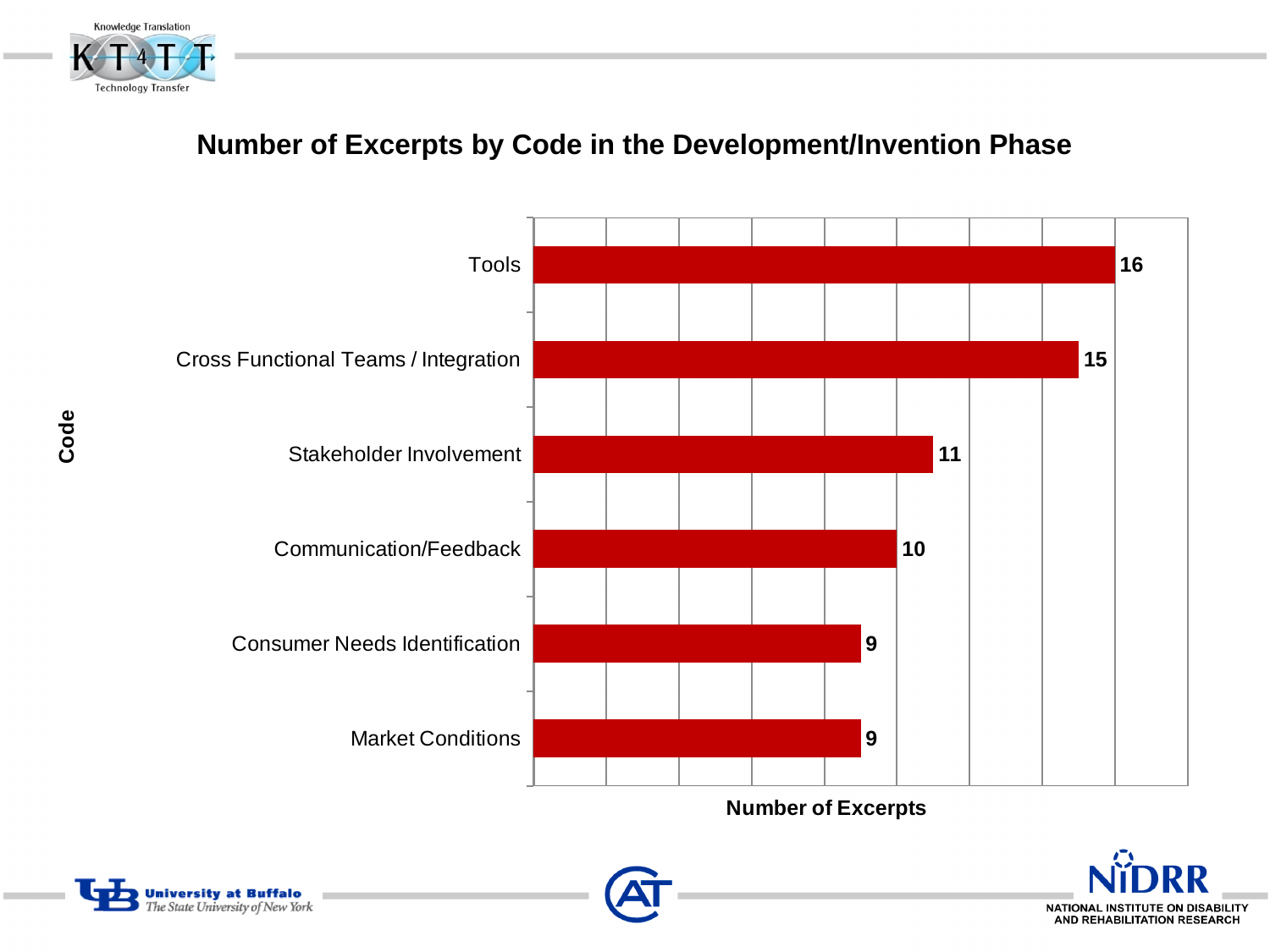
What is the number of excerpts for Communication/Feedback? 10 What is the number of excerpts for Stakeholder Involvement? 11 What is the number of excerpts for Cross Functional Teams / Integration? 15 What kind of chart is shown on the slide? Bar chart What is the difference in number of excerpts between Cross Functional Teams / Integration and Stakeholder Involvement? 4 Which has more excerpts, Stakeholder Involvement or Communication/Feedback? Stakeholder Involvement What is the number of excerpts for Tools? 16 What is the difference in number of excerpts between Tools and Market Conditions? 7 Which code has the highest number of excerpts? Tools How many codes are shown in the chart? 6 What is the title of the chart? Number of Excerpts by Code in the Development/Invention Phase What is the label of the horizontal axis? Number of Excerpts